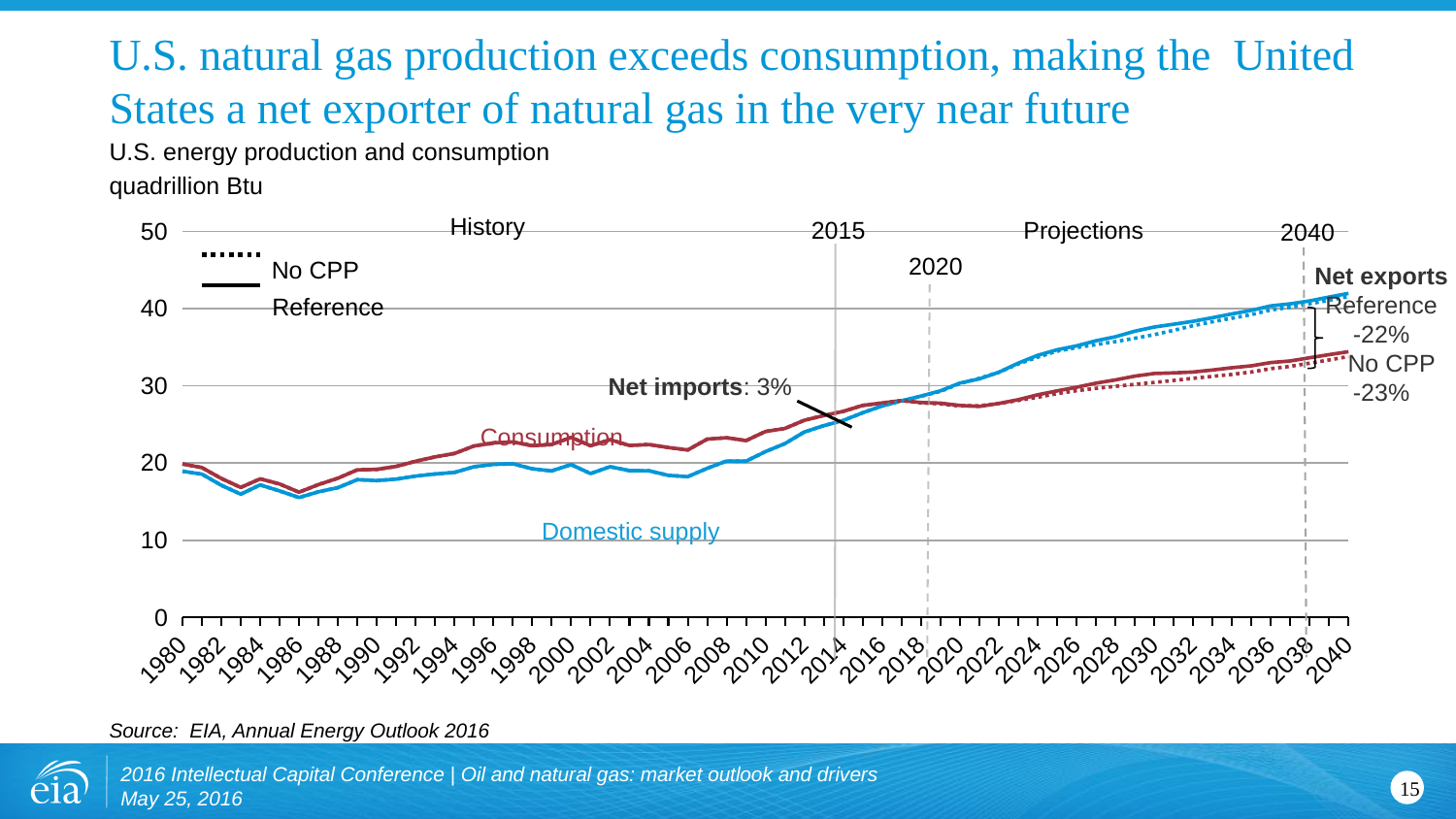
What kind of chart is shown on the slide? line chart Is the value for Consumption in 1980 greater or less than 30? less In 2000, which line is higher, Consumption or Domestic supply? Consumption Is the value for Domestic supply in 1986 greater or less than 20? less In 2040, which line is higher, Consumption or Domestic supply? Domestic supply In the chart legend, what does the dotted line style represent? No CPP Is the value for Domestic supply in 2040 greater or less than 40? greater What unit is the y axis of the chart measured in? quadrillion Btu What net imports percentage is labeled on the chart around 2015? 3% What net exports percentage is labeled for the Reference case in 2040? -22% What net exports percentage is labeled for the No CPP case in 2040? -23% How many entries does the chart legend list? 2